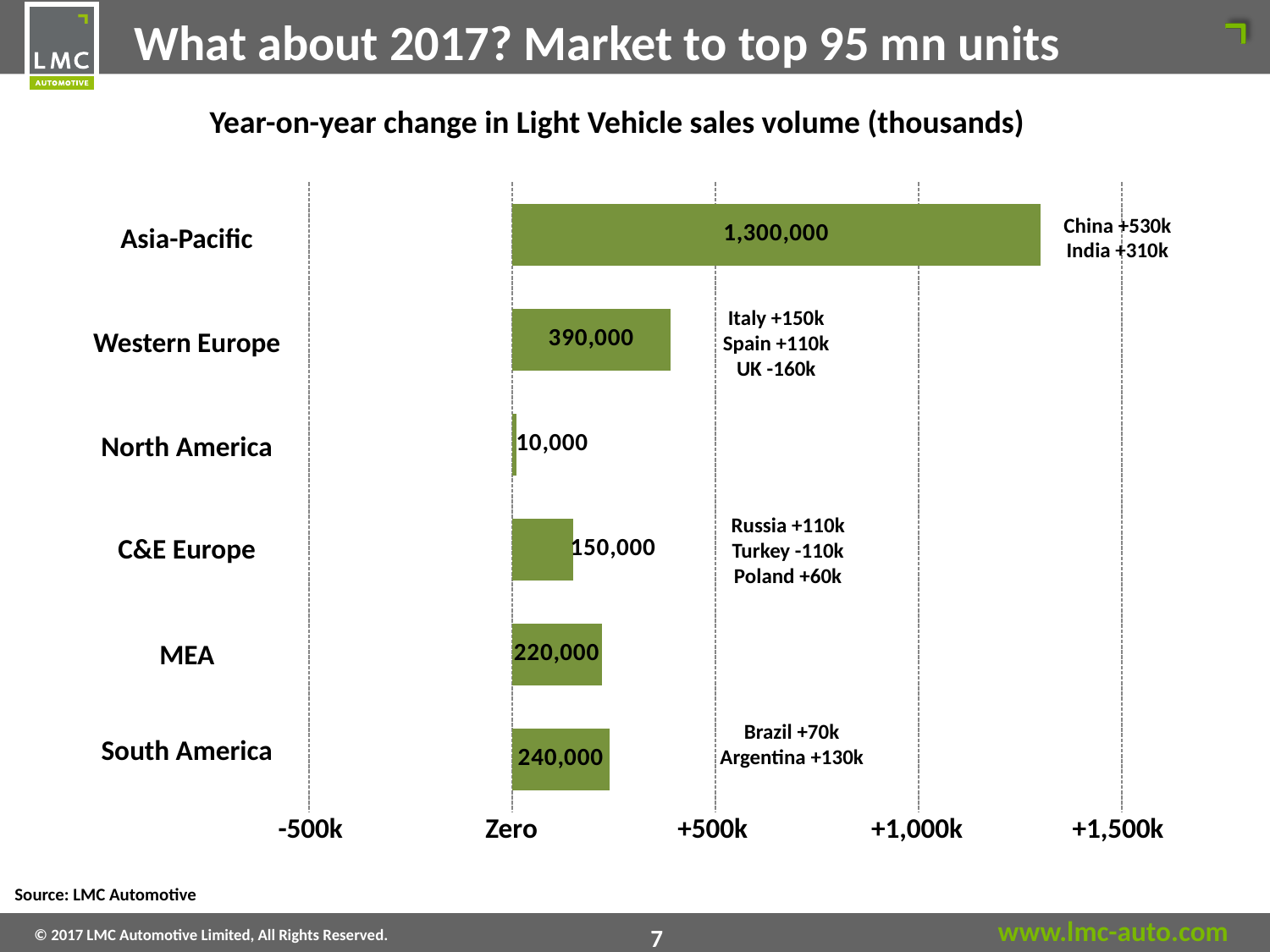
What is the difference between the values for South America and MEA? 20,000 What kind of chart is shown on the slide? Bar chart How many regions are shown in the chart? 6 What is the difference between the values for Asia-Pacific and Western Europe? 910,000 What is the year-on-year change in Light Vehicle sales volume for Asia-Pacific? 1,300,000 What is the value shown for South America? 240,000 Is the value for Asia-Pacific greater or less than +1,000k? greater What is the value shown for Western Europe? 390,000 Which region has the smallest year-on-year change in Light Vehicle sales volume? North America Which has a larger value, C&E Europe or MEA? MEA What is the value shown for North America? 10,000 Which region has the largest year-on-year change in Light Vehicle sales volume? Asia-Pacific